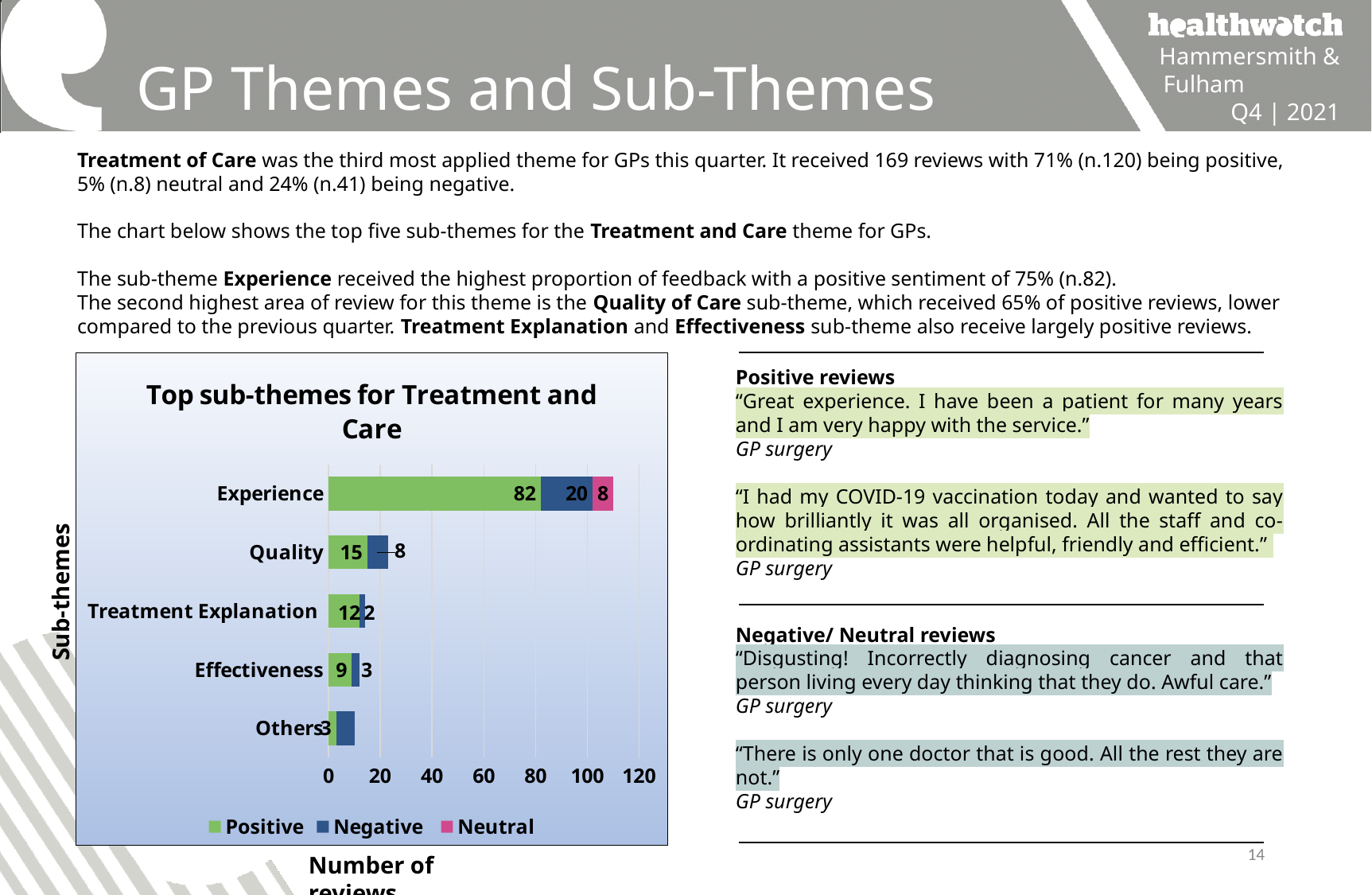
What is the Negative value for Experience? 20 What is the Positive value for Experience? 82 What is the Positive value for Treatment Explanation? 12 What is the total of the stacked bar for Experience? 110 What type of chart is shown on the slide? Bar chart What is the difference between the Positive values for Experience and Quality? 67 Which sub-theme has the highest Positive value? Experience How many series does the legend of the chart list? 3 What is the Neutral value for Experience? 8 How many sub-themes are plotted in the chart? 5 Which has the larger Negative value, Experience or Quality? Experience What is the Positive value for Quality? 15